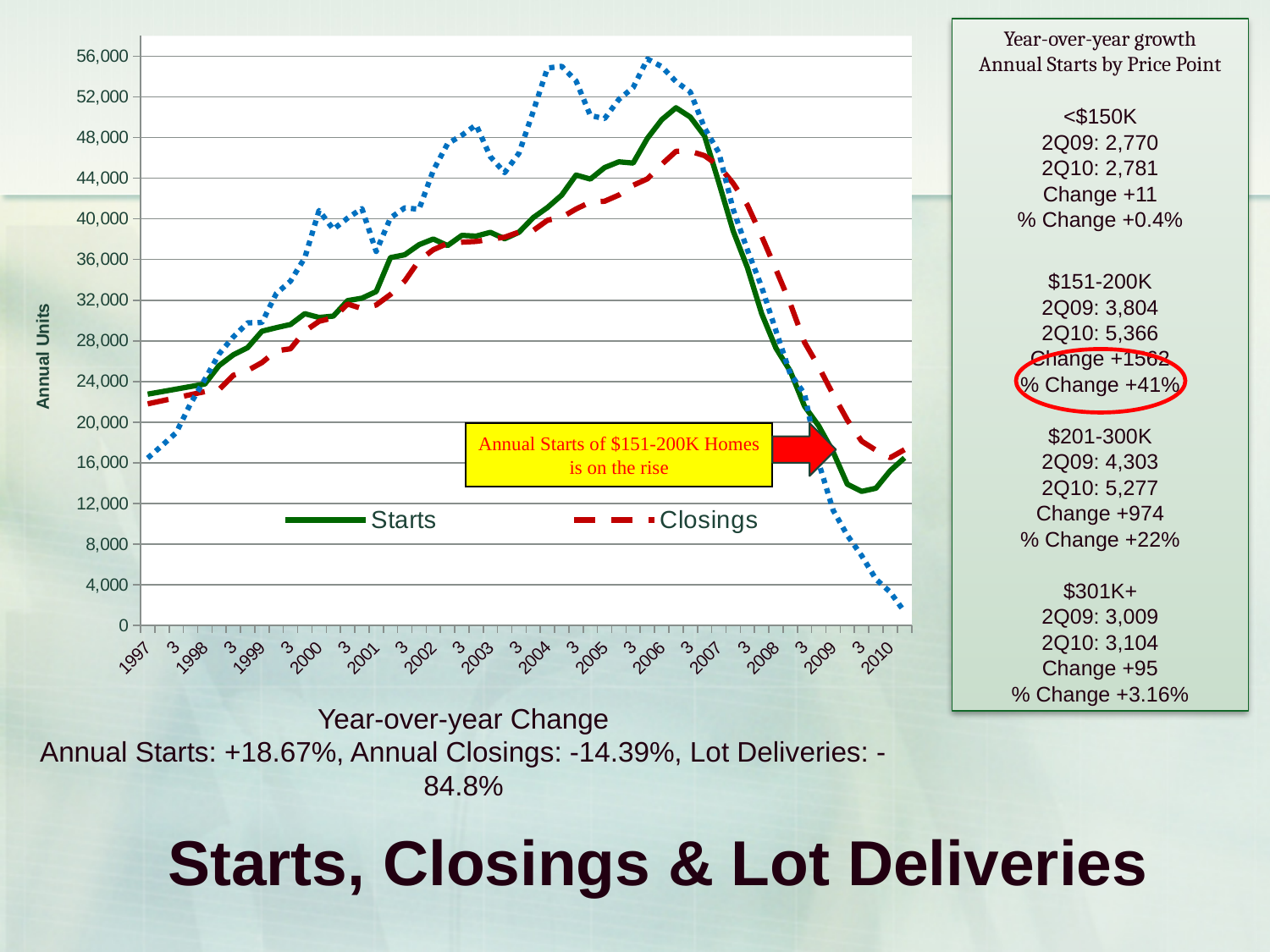
Is the peak value of Starts around 2006 greater or less than 48,000? greater What kind of chart is shown on the slide? line chart Is the value of Closings at 2010 greater or less than 20,000? less Do Starts rise or fall between 2007 and 2009? fall Which series is drawn as a red dashed line? Closings Is the value of Closings at 1997 greater or less than 28,000? less How many series does the chart's legend list? 2 Do Starts generally rise or fall between 1997 and 2006? rise At the 2006 peak, which is higher, Starts or Closings? Starts What is the label on the chart's vertical axis? Annual Units